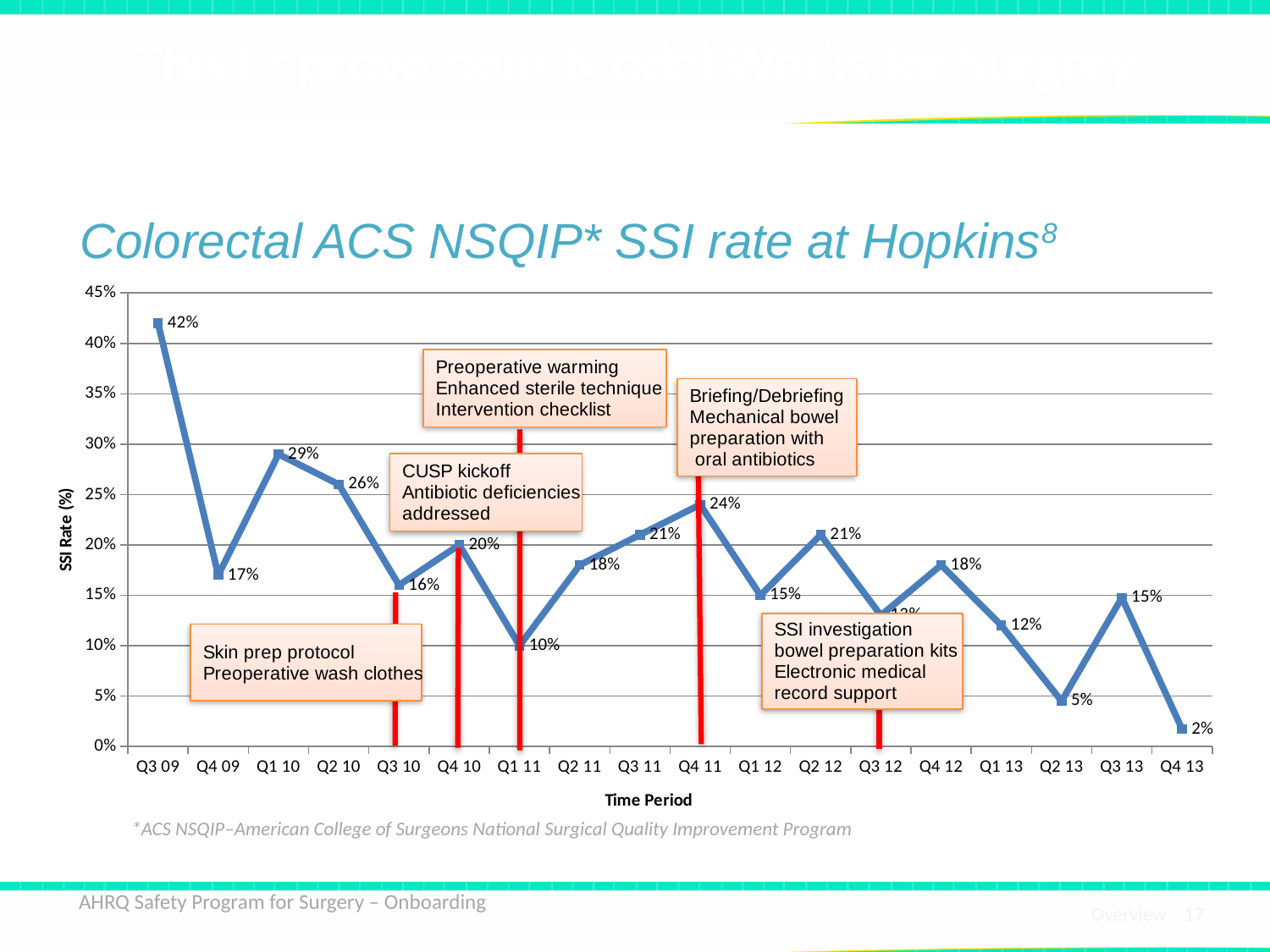
What is the SSI rate for Q3 09? 42% What is the SSI rate for Q4 11? 24% Is the SSI rate for Q2 13 greater or less than 10%? less What is the SSI rate for Q4 13? 2% What is the difference between the SSI rate in Q3 09 and Q4 09? 25% Which has a higher SSI rate, Q1 10 or Q2 10? Q1 10 Which time period has the lowest SSI rate? Q4 13 What kind of chart is shown on the slide? line chart What is the SSI rate for Q1 11? 10% How many time periods are plotted on the x axis? 18 What is the label of the y axis? SSI Rate (%) Which time period has the highest SSI rate? Q3 09